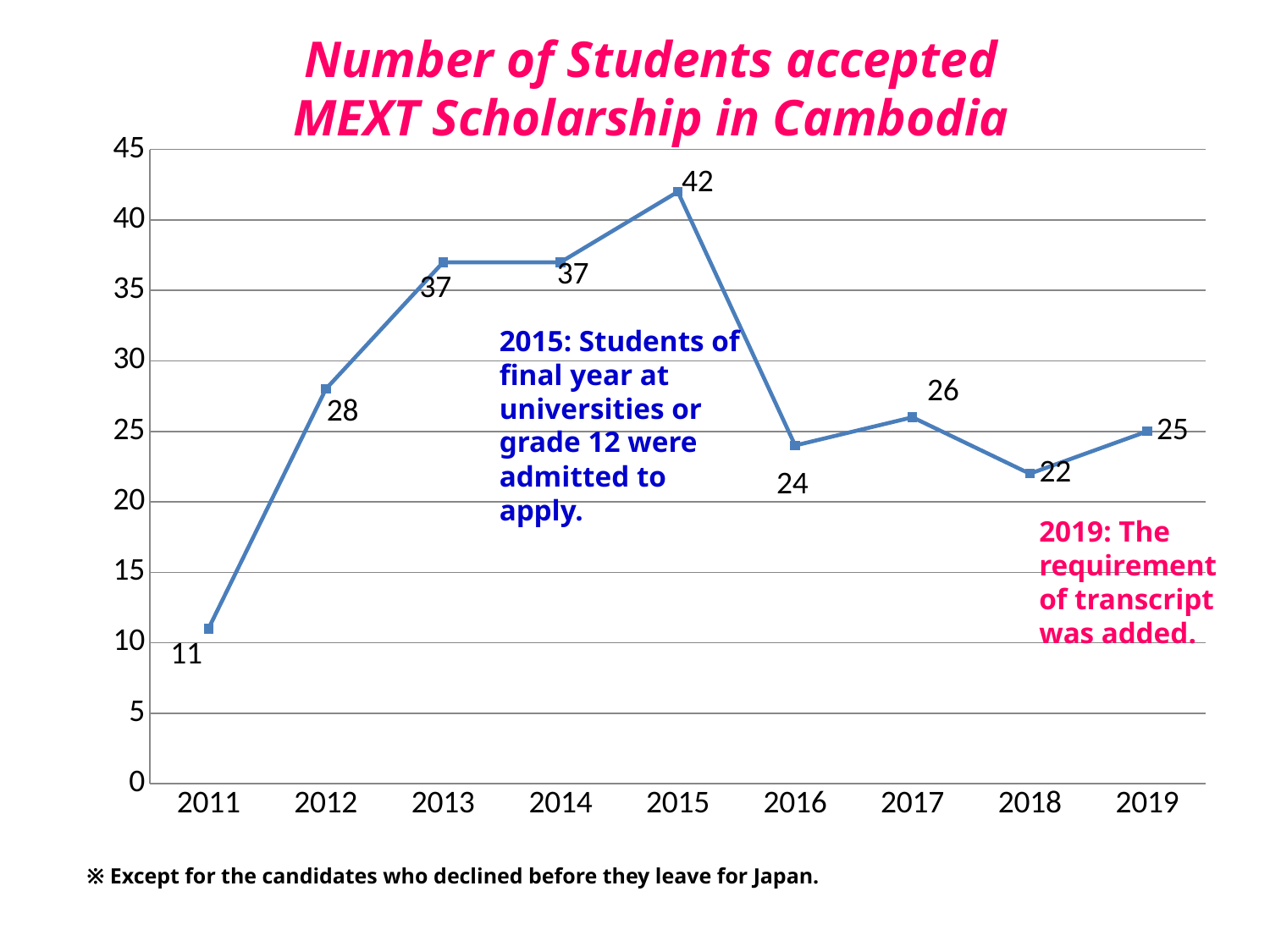
What is the number of students accepted in 2015? 42 What is the title of the chart? Number of Students accepted MEXT Scholarship in Cambodia What is the difference between the number of students accepted in 2012 and in 2011? 17 What is the number of students accepted in 2018? 22 Which year has the highest number of students accepted? 2015 Did the number of students accepted rise or fall from 2011 to 2013? Rise What is the difference between the number of students accepted in 2015 and in 2016? 18 How many years are plotted on the chart? 9 What kind of chart is shown on the slide? Line chart Which year has the lowest number of students accepted? 2011 What is the number of students accepted in 2011? 11 Which year had more students accepted, 2017 or 2019? 2017